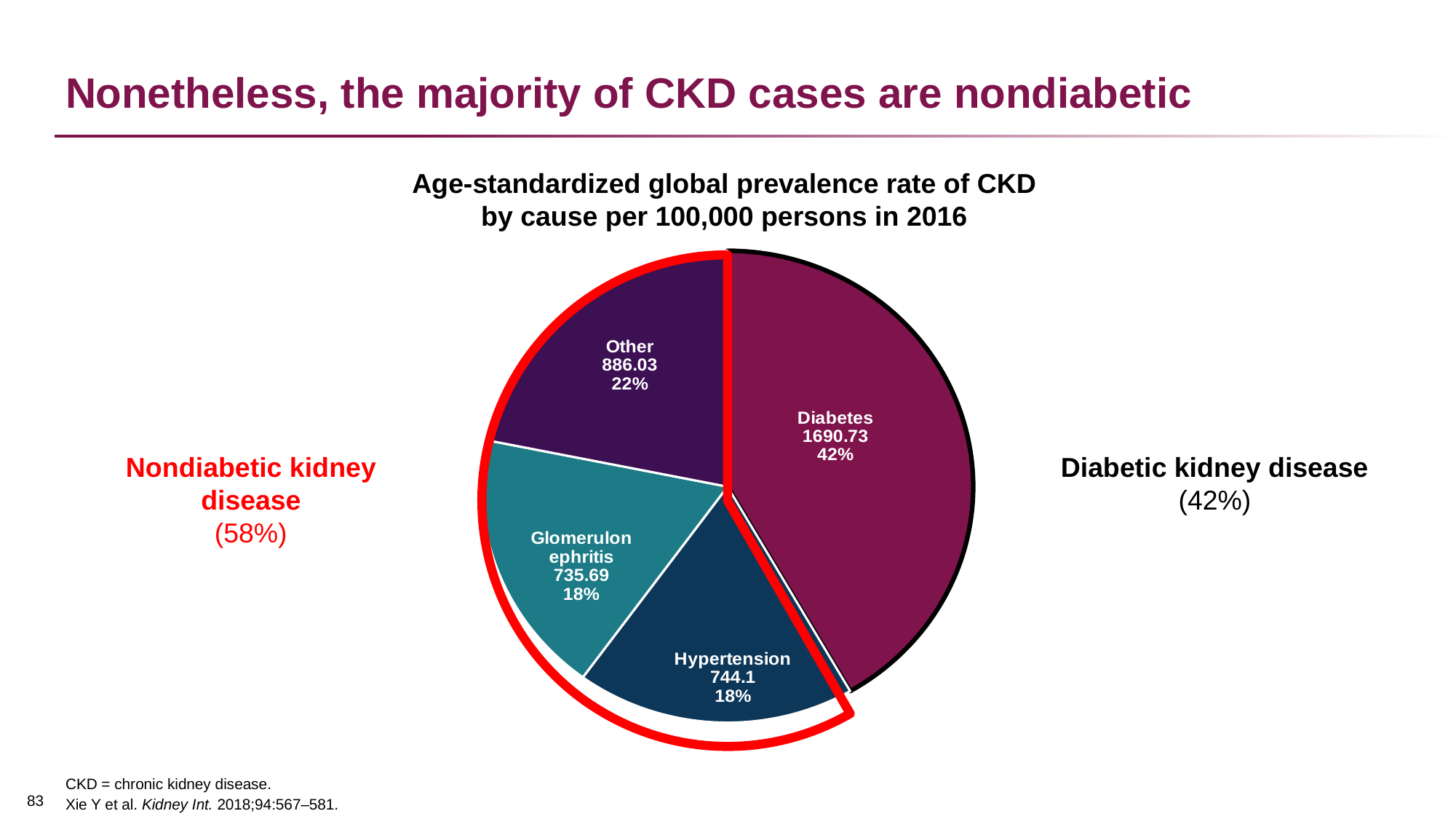
What is the prevalence rate value for Glomerulonephritis? 735.69 What is the prevalence rate value for Hypertension? 744.1 What is the difference between the Diabetes value and the Other value? 804.7 What is the title of the pie chart? Age-standardized global prevalence rate of CKD by cause per 100,000 persons in 2016 Which cause has the largest slice of the pie? Diabetes What is the prevalence rate value for Diabetes? 1690.73 What share of the pie does the Other slice represent? 22% What share of the pie does the Diabetes slice represent? 42% Which cause has the smallest slice of the pie? Glomerulonephritis How many slices does the pie chart have? 4 What type of chart is shown on the slide? pie chart What is the prevalence rate value for Other? 886.03